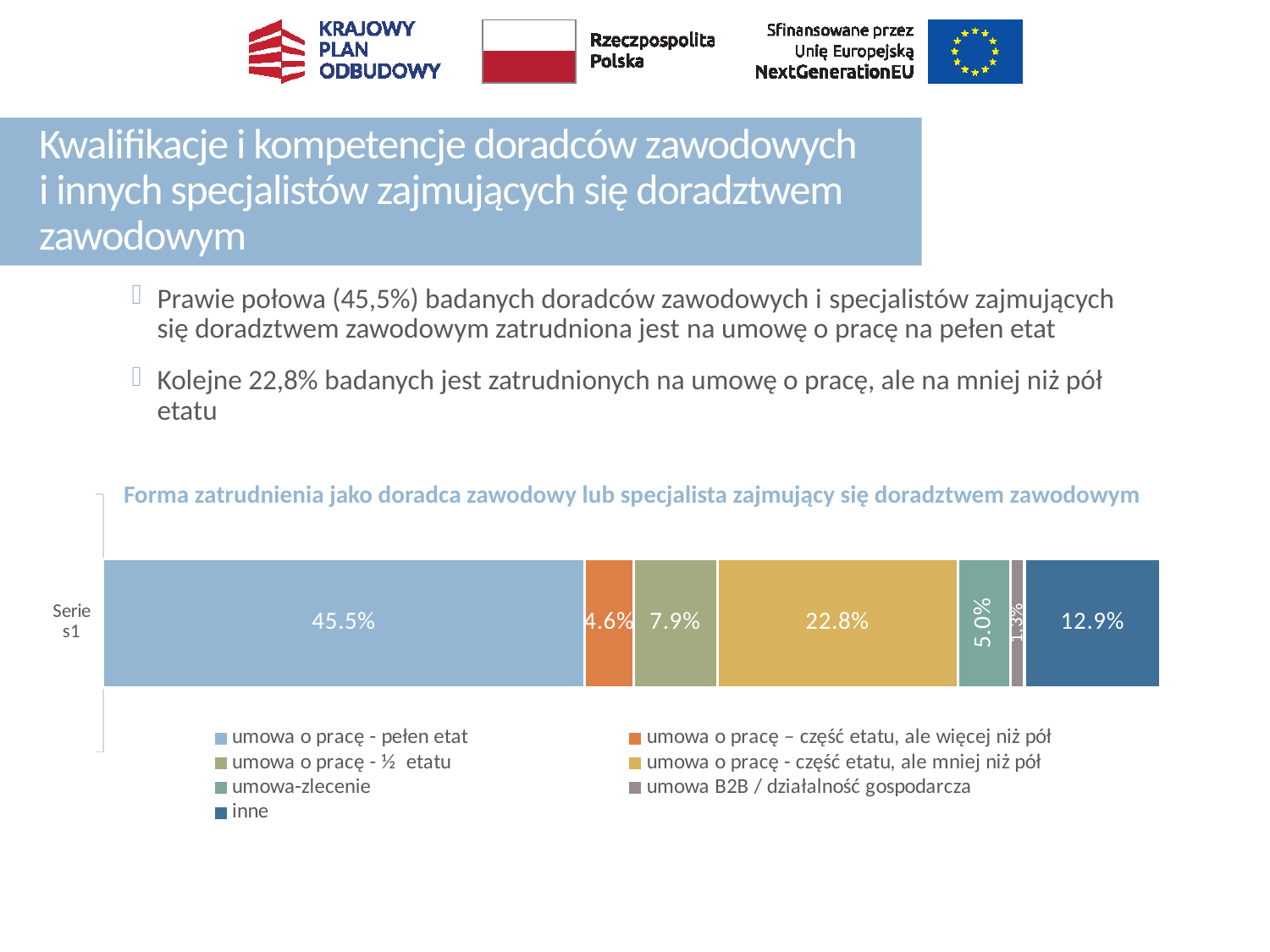
What is the value for 'inne'? 12.9% What is the difference between the values for 'umowa o pracę - pełen etat' and 'umowa o pracę - część etatu, ale mniej niż pół'? 22.7% What type of chart is shown on the slide? stacked bar chart What is the title of the chart? Forma zatrudnienia jako doradca zawodowy lub specjalista zajmujący się doradztwem zawodowym Which employment form has the highest share in the chart? umowa o pracę - pełen etat What is the value for 'umowa o pracę - pełen etat'? 45.5% Which is larger: the value for 'umowa o pracę - ½ etatu' or the value for 'umowa o pracę – część etatu, ale więcej niż pół'? umowa o pracę - ½ etatu What is the value for 'umowa-zlecenie'? 5.0% What is the total of all segments in the stacked bar? 100.0% How many series does the chart legend list? 7 What is the value for 'umowa o pracę - część etatu, ale mniej niż pół'? 22.8% Which employment form has the lowest share in the chart? umowa B2B / działalność gospodarcza